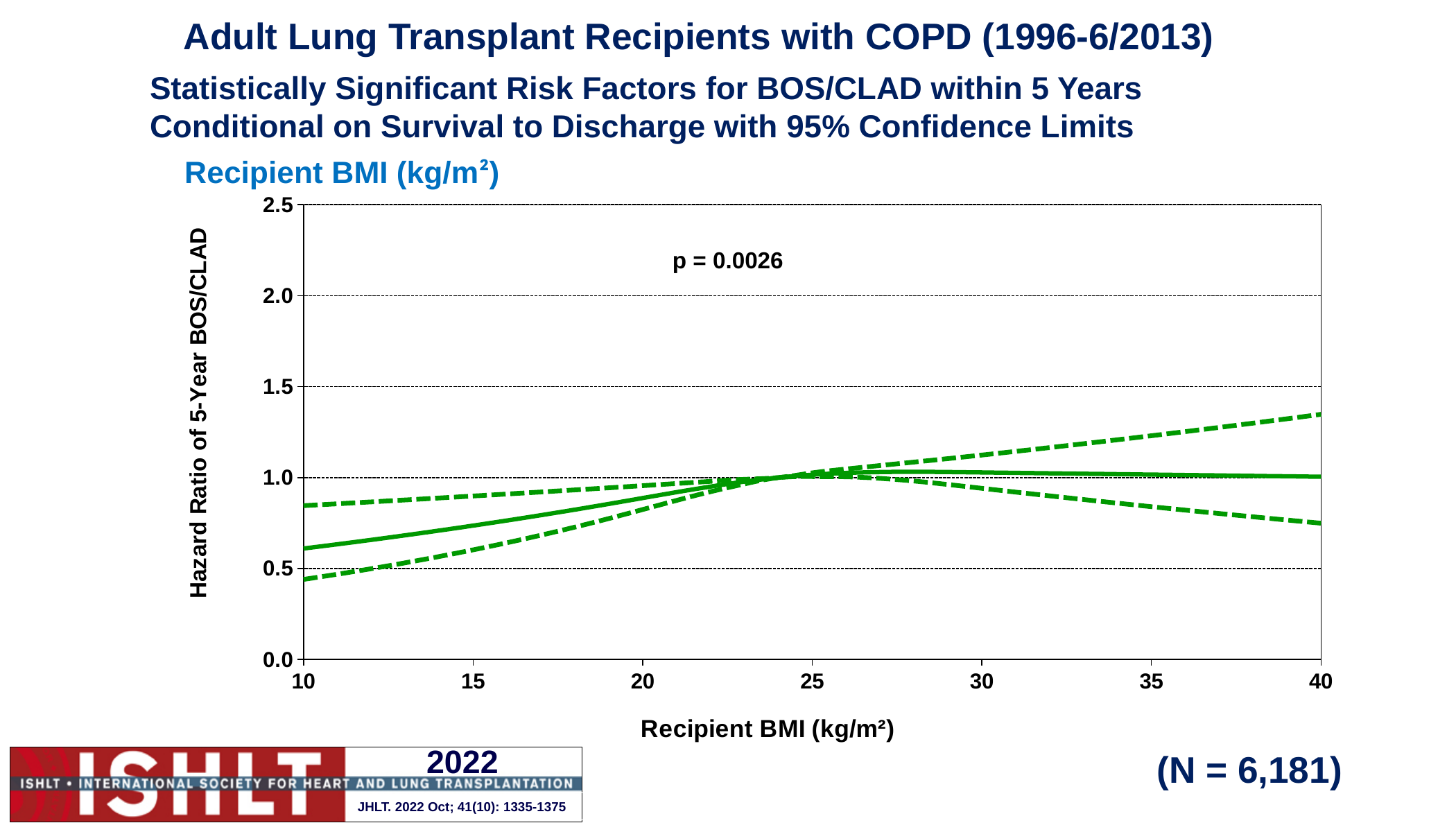
Is the upper 95% confidence limit (upper dashed line) at a recipient BMI of 40 greater or less than 1.5? less Is the hazard ratio (solid line) at a recipient BMI of 10 greater or less than 0.5? greater Does the lower 95% confidence limit (lower dashed line) rise or fall as recipient BMI increases from 30 to 40? fall Is the lower 95% confidence limit (lower dashed line) at a recipient BMI of 40 greater or less than 1.0? less How many lines are plotted on the chart? 3 Does the hazard ratio (solid line) rise or fall as recipient BMI increases from 10 to 25? rise What p-value is printed on the chart? p = 0.0026 What kind of chart is shown on the slide? line chart Which is larger at a recipient BMI of 10: the upper dashed line or the lower dashed line? the upper dashed line What is the label of the y-axis? Hazard Ratio of 5-Year BOS/CLAD